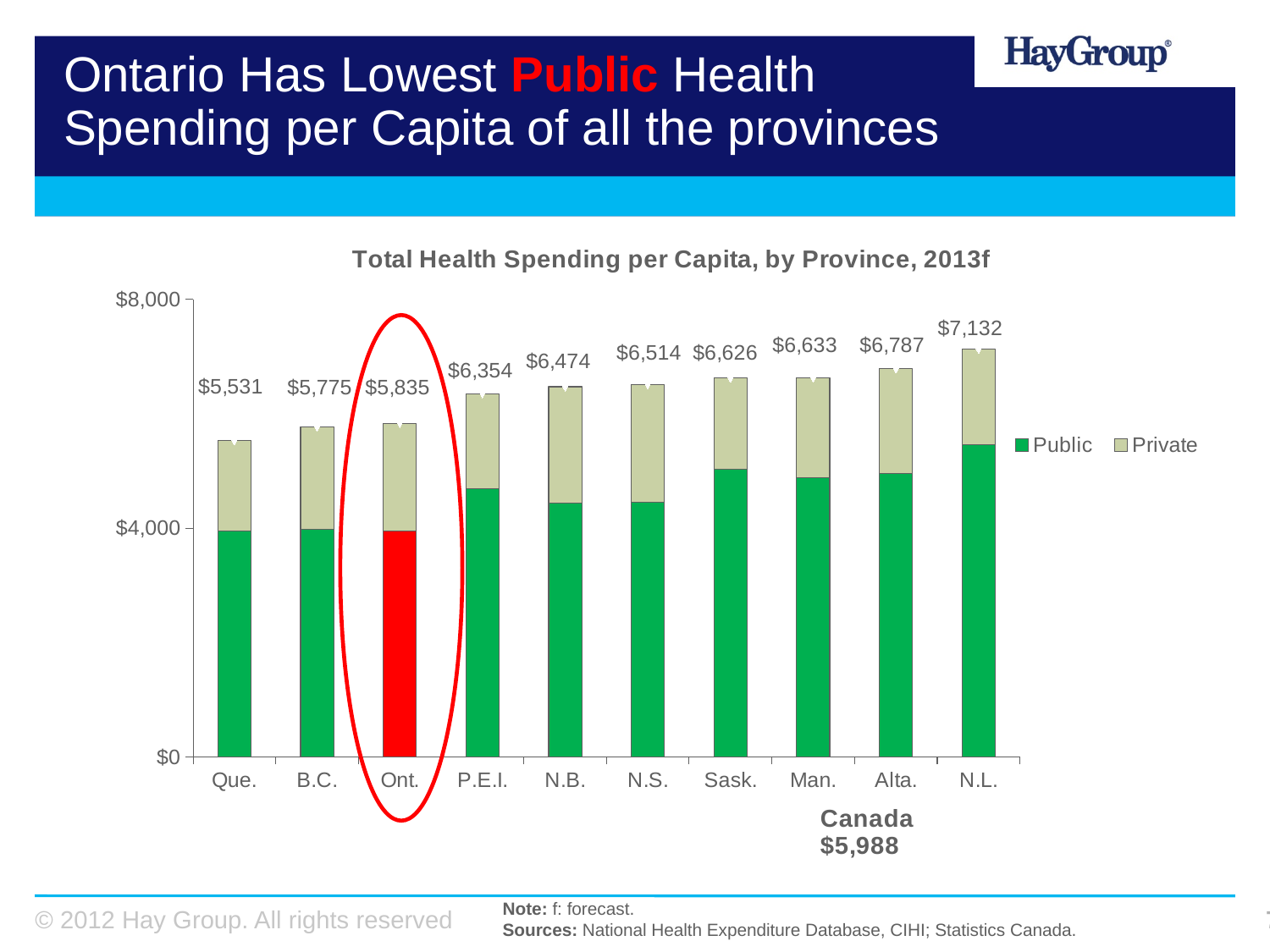
Do the total health spending values rise or fall from Que. to N.L. along the x axis? Rise What kind of chart is shown on the slide? Stacked bar chart How many provinces are shown on the x axis of the chart? 10 What is the total health spending per capita for N.L.? $7,132 What is the total health spending per capita for Sask.? $6,626 Which province has the lowest total health spending per capita? Que. Which province has the highest total health spending per capita? N.L. What is the total health spending per capita for Ontario? $5,835 Which has higher total health spending per capita, Alta. or Man.? Alta. What is the difference in total health spending per capita between N.L. and Que.? $1,601 Is the Public spending value for N.L. greater or less than $4,000? greater How many series does the legend list? 2